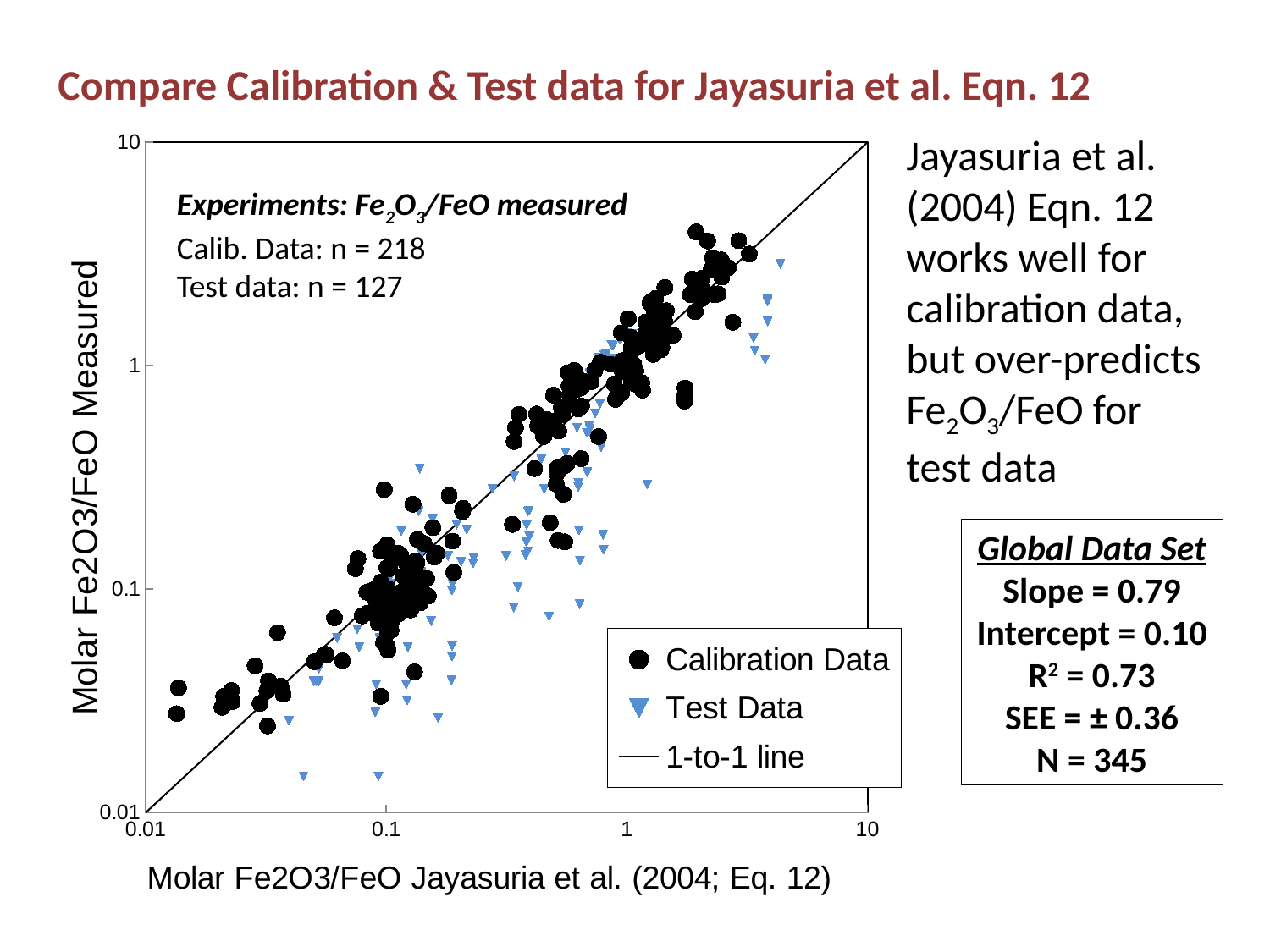
According to the annotation on the chart, how many test data points are there? 127 What is the label of the x axis? Molar Fe2O3/FeO Jayasuria et al. (2004; Eq. 12) Do the plotted points generally rise or fall as the x-axis value increases? rise How many entries does the chart legend list? 3 According to the annotation on the chart, how many calibration data points are there? 218 What R² value is reported in the Global Data Set box? 0.73 What intercept is reported in the Global Data Set box? 0.10 Which legend entry is shown with blue triangle markers? Test Data What SEE value is reported in the Global Data Set box? ± 0.36 What is the total number of data points N given in the Global Data Set box? 345 What slope is reported in the Global Data Set box? 0.79 What kind of chart is shown on the slide? scatter plot